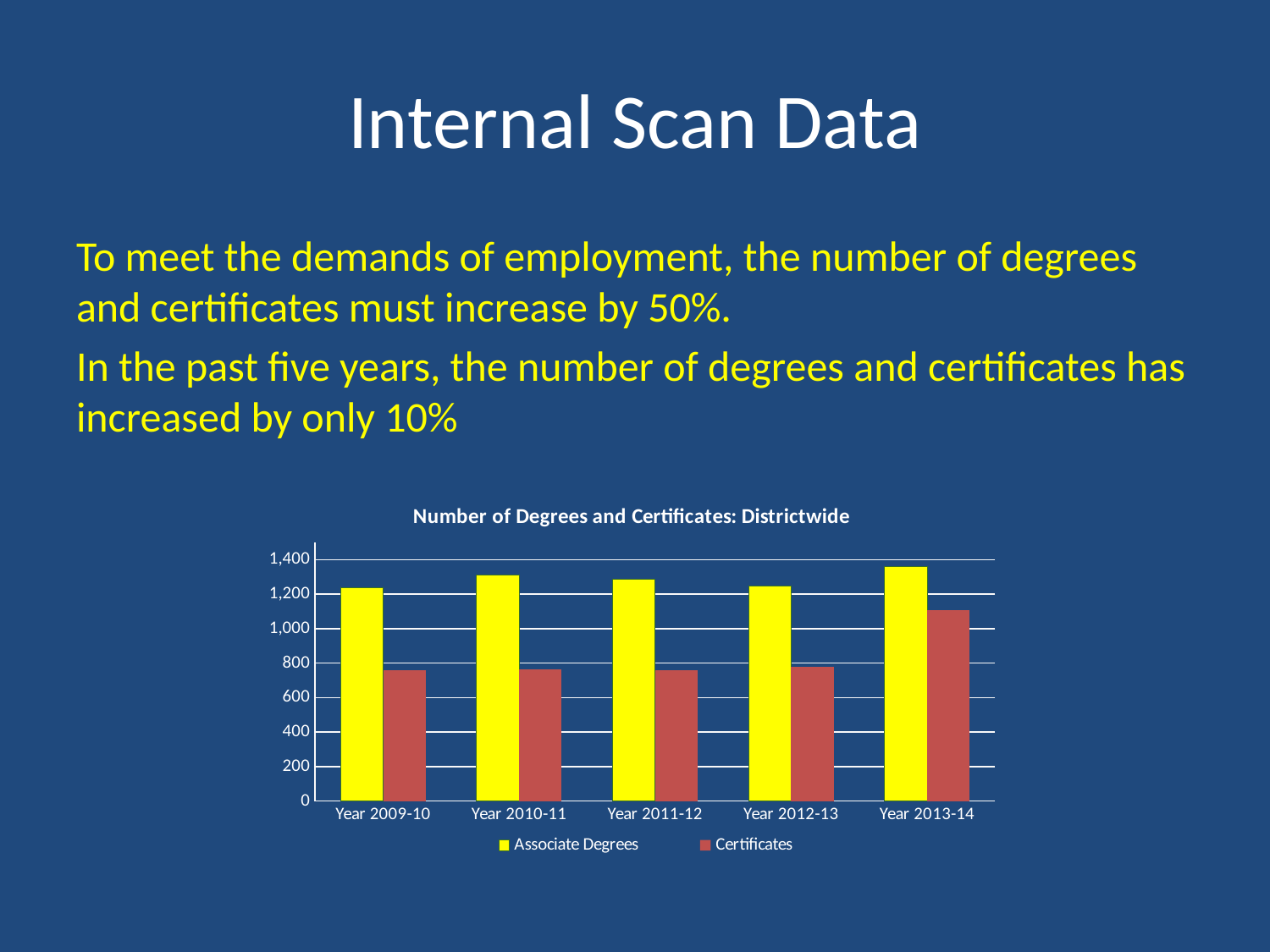
Which year has the highest value for Associate Degrees? Year 2013-14 How many years are shown on the x axis of the chart? 5 Which colour represents Certificates in the chart? Red What kind of chart is shown on the slide? Bar chart Which year has the highest value for Certificates? Year 2013-14 In Year 2012-13, which is larger: Associate Degrees or Certificates? Associate Degrees Is the value for Associate Degrees in Year 2010-11 greater or less than 1,200? greater Is the value for Associate Degrees in Year 2011-12 greater or less than 1,400? less Is the value for Certificates in Year 2013-14 greater or less than 1,000? greater What is the title of the chart? Number of Degrees and Certificates: Districtwide How many series does the chart's legend list? 2